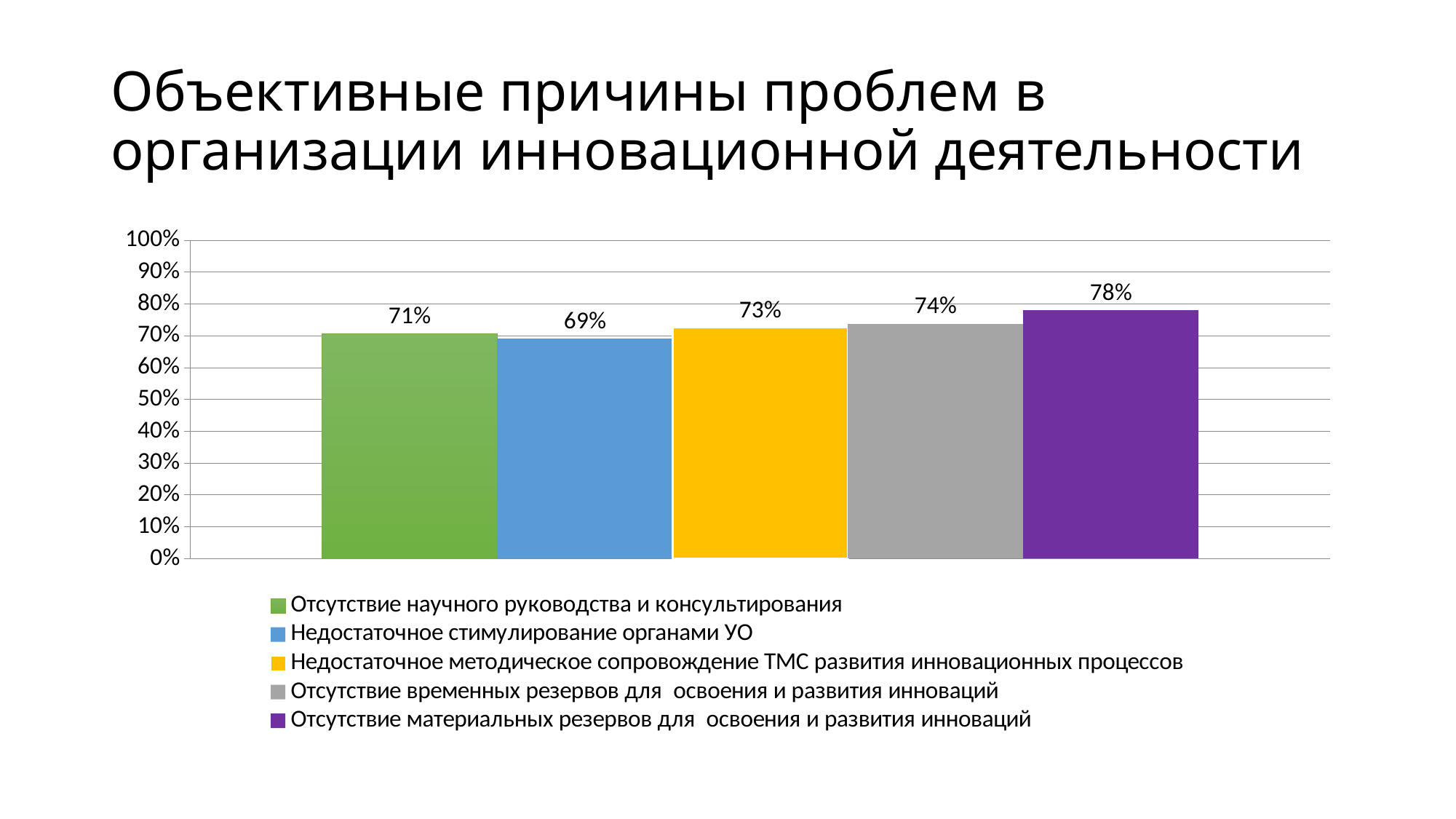
Which series has the highest value? Отсутствие материальных резервов для освоения и развития инноваций What is the value for «Отсутствие материальных резервов для освоения и развития инноваций»? 78% Which is larger: the value for «Недостаточное методическое сопровождение ТМС развития инновационных процессов» or the value for «Отсутствие научного руководства и консультирования»? Недостаточное методическое сопровождение ТМС развития инновационных процессов What is the value for «Отсутствие временных резервов для освоения и развития инноваций»? 74% Is the value for «Недостаточное стимулирование органами УО» greater or less than 80%? less What is the value for «Отсутствие научного руководства и консультирования»? 71% What is the difference between the values for «Отсутствие материальных резервов для освоения и развития инноваций» and «Недостаточное стимулирование органами УО»? 9% Which series has the lowest value? Недостаточное стимулирование органами УО How many series does the legend list? 5 How many bars are plotted on the chart? 5 What is the value for «Недостаточное стимулирование органами УО»? 69% What kind of chart is shown on the slide? bar chart